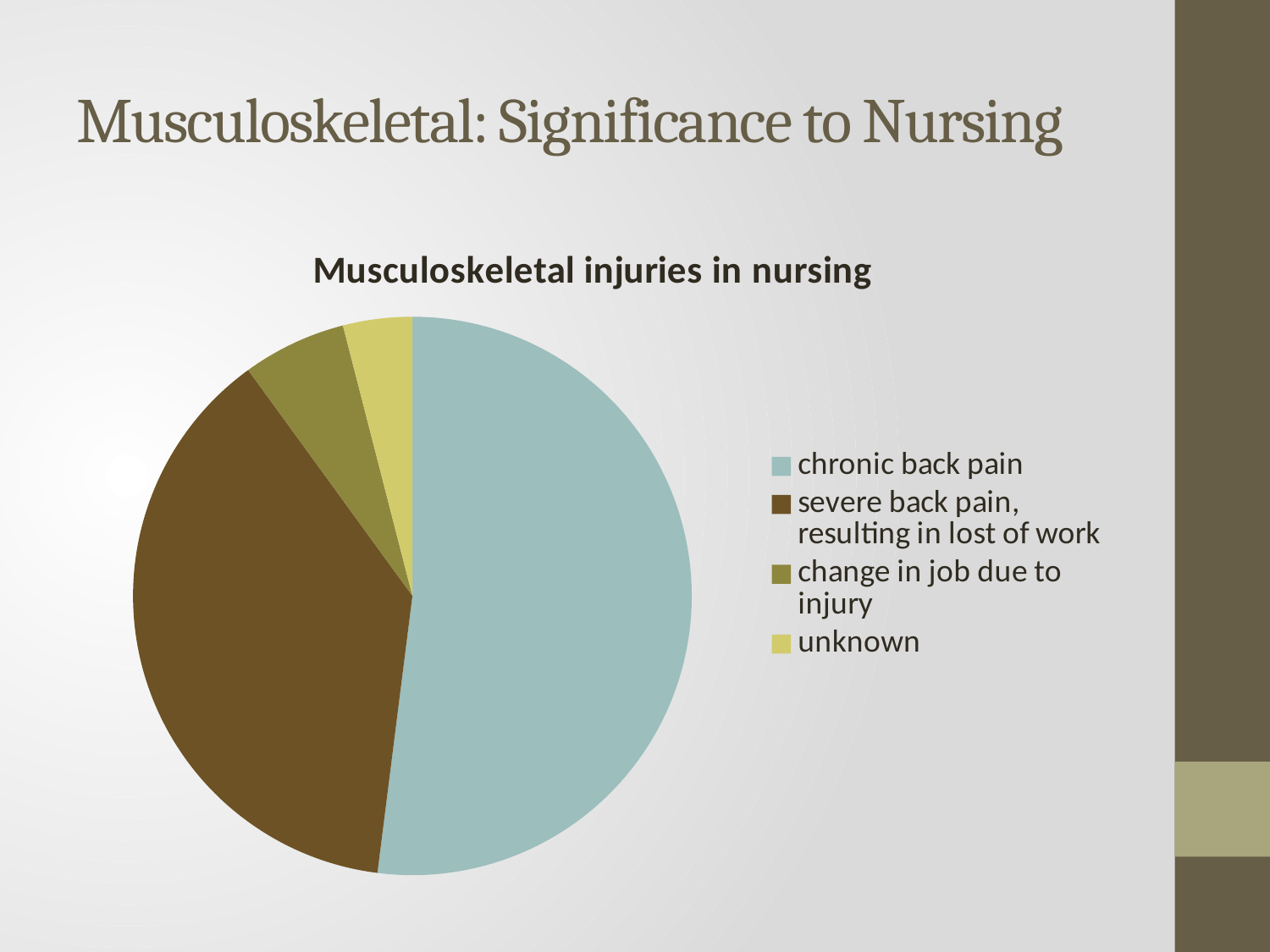
How many slices does the pie chart have? 4 Which slice is larger: chronic back pain or severe back pain, resulting in lost of work? chronic back pain Which category has the largest slice of the pie? chronic back pain What kind of chart is shown on the slide? pie chart How many entries does the legend list? 4 Which category has the smallest slice of the pie? unknown Which category is shown in the light blue colour? chronic back pain Which slice is larger: severe back pain, resulting in lost of work or change in job due to injury? severe back pain, resulting in lost of work What is the title of the chart? Musculoskeletal injuries in nursing Which slice is larger: change in job due to injury or unknown? change in job due to injury